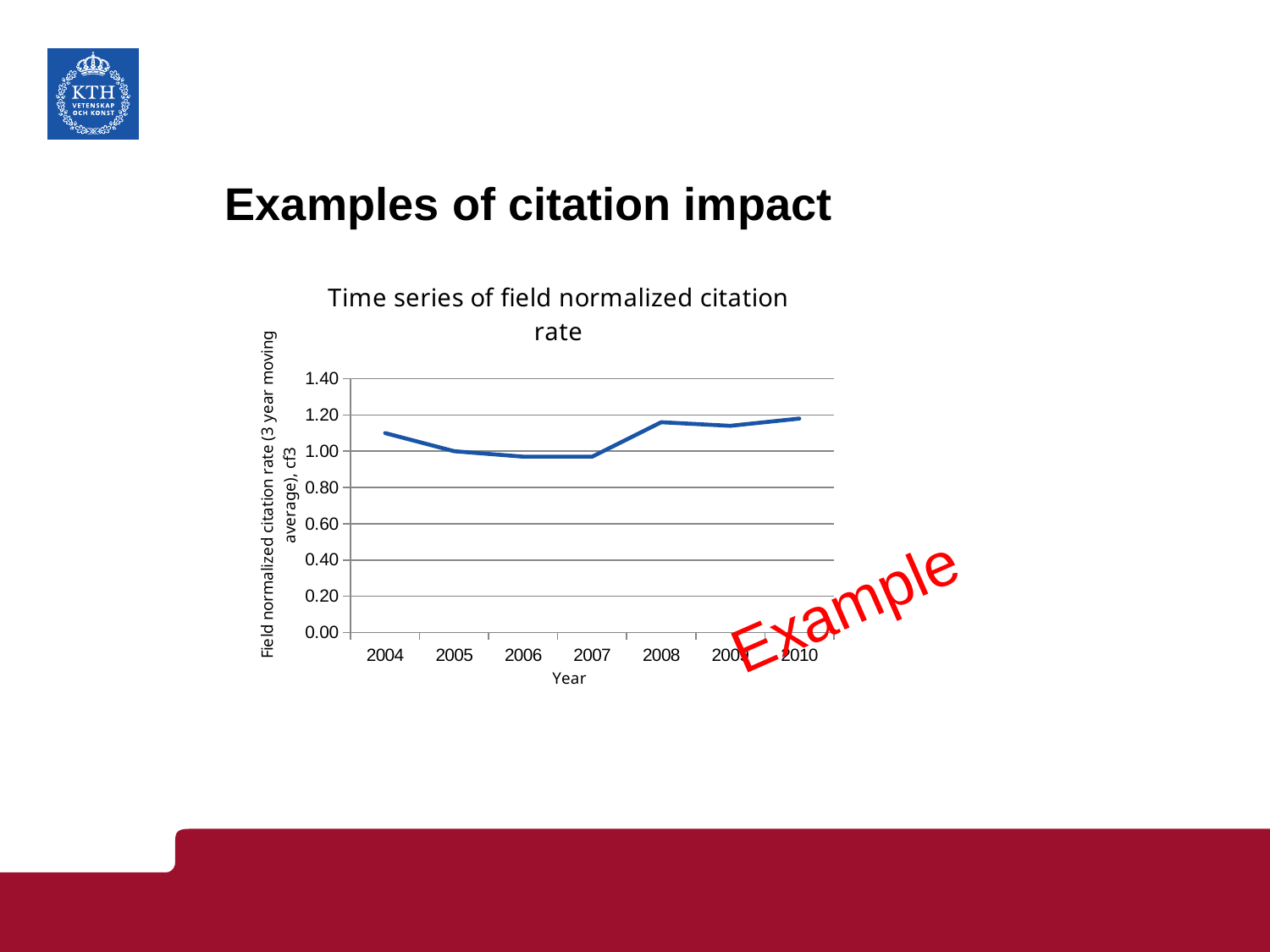
What is the title of the chart? Time series of field normalized citation rate How many years are plotted on the x axis of the chart? 7 Is the value for 2007 greater or less than 0.80? greater What is the label of the x axis? Year Is the value for 2010 greater or less than 1.40? less Is the value for 2008 greater or less than 1.00? greater Which year has the higher value, 2005 or 2008? 2008 Does the value rise or fall from 2004 to 2006? fall Which year has the higher value, 2004 or 2006? 2004 What kind of chart is shown on the slide? line chart